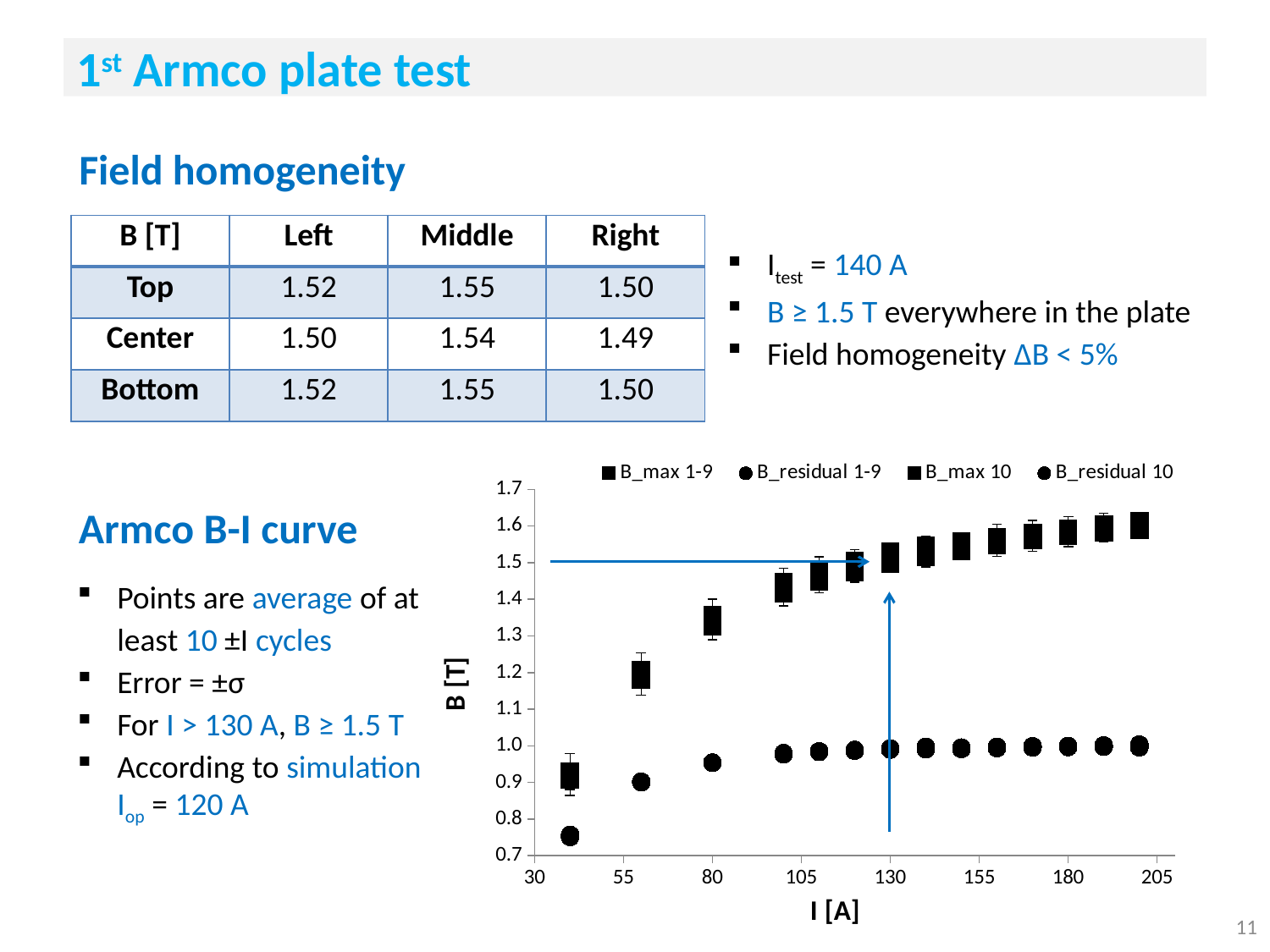
In the B-I curve chart, at about 200 A, which is larger: B_max or B_residual? B_max What kind of chart is the Armco B-I curve chart? scatter chart How many series does the legend of the B-I curve chart list? 4 In the B-I curve chart, does B_max rise or fall as I increases along the x axis? rise What is the label of the y axis of the B-I curve chart? B [T] In the B-I curve chart, is the B_max value at about 80 A greater or less than 1.5? less In the B-I curve chart, is the B_max value at the lowest current (about 40 A) greater or less than 1.0? less What is the first entry in the legend of the B-I curve chart? B_max 1-9 In the B-I curve chart, is the B_residual value at about 200 A greater or less than 1.1? less